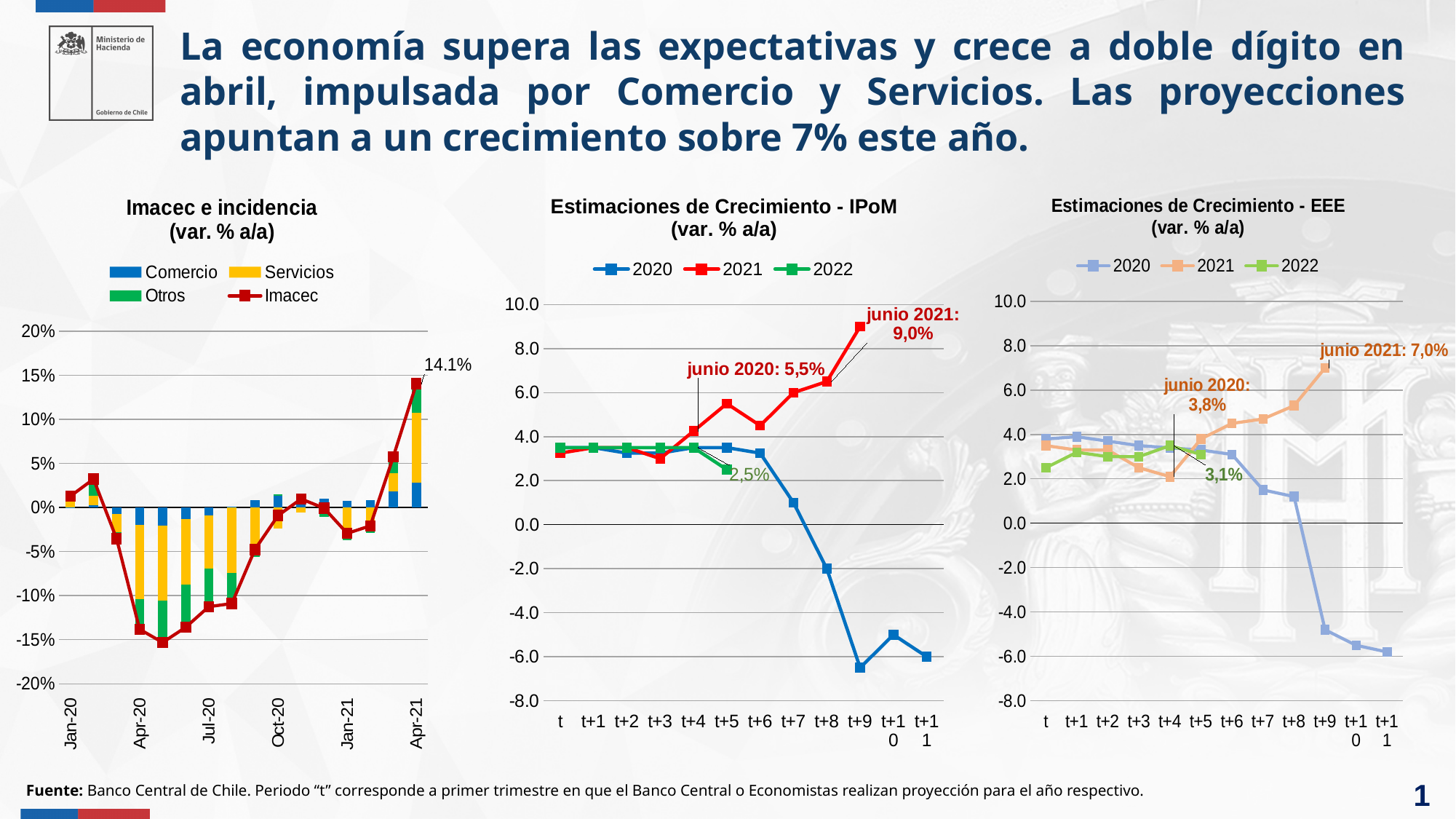
What kind of chart is 'Estimaciones de Crecimiento - IPoM'? Line chart How many series does the legend of the 'Imacec e incidencia' chart list? 4 In the 'Estimaciones de Crecimiento - EEE' chart, what is the value labelled for junio 2021? 7,0% In the 'Estimaciones de Crecimiento - IPoM' chart, does the 2020 series rise or fall from t+6 to t+9? Fall In the 'Estimaciones de Crecimiento - EEE' chart, is the 2020 value at t+9 greater or less than -4.0? less In the 'Estimaciones de Crecimiento - IPoM' chart, what is the difference between the junio 2021 value and the junio 2020 value? 3,5 In the 'Imacec e incidencia' chart, what is the Imacec value labelled for Apr-21? 14.1% In the 'Estimaciones de Crecimiento - EEE' chart, what value is labelled on the 2022 series? 3,1% In the 'Estimaciones de Crecimiento - EEE' chart, what is the value labelled for junio 2020? 3,8% In the 'Estimaciones de Crecimiento - IPoM' chart, what is the 2021 growth estimate labelled for junio 2021? 9,0% Which chart shows the larger junio 2021 estimate, 'Estimaciones de Crecimiento - IPoM' or 'Estimaciones de Crecimiento - EEE'? Estimaciones de Crecimiento - IPoM In the 'Estimaciones de Crecimiento - IPoM' chart, what is the value labelled for junio 2020? 5,5%